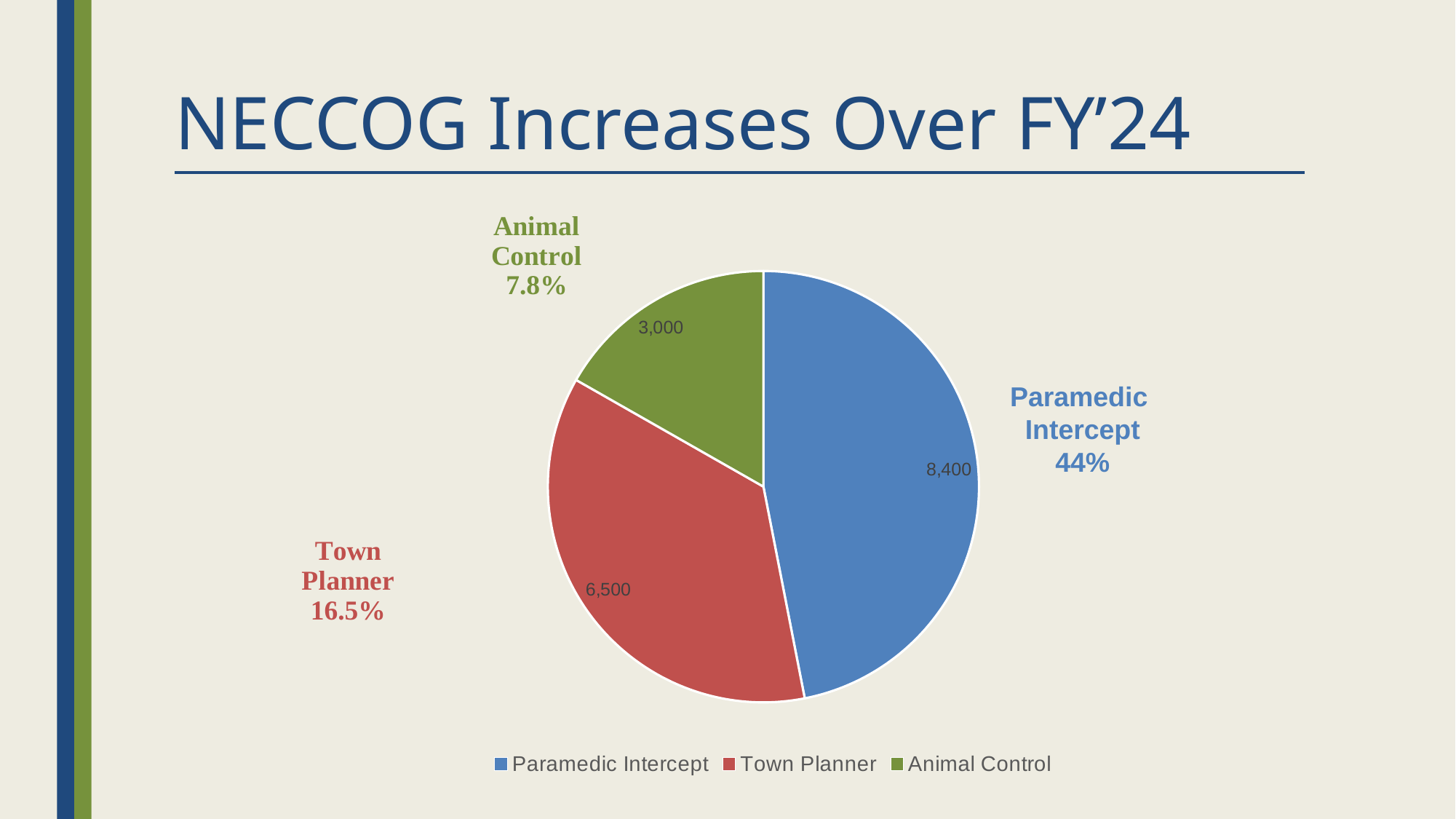
Which category has the largest slice of the pie? Paramedic Intercept What is the value shown for the Animal Control slice? 3,000 How many categories are shown in the pie chart? 3 Which category has the smallest slice of the pie? Animal Control What is the value shown for the Town Planner slice? 6,500 What is the difference between the Paramedic Intercept value and the Town Planner value? 1,900 What is the difference between the Town Planner value and the Animal Control value? 3,500 Which is larger, the Town Planner value or the Animal Control value? Town Planner What is the title of the slide containing the chart? NECCOG Increases Over FY'24 What percentage increase is labelled next to the Town Planner slice? 16.5% What is the value shown for the Paramedic Intercept slice? 8,400 What kind of chart is shown on the slide? Pie chart